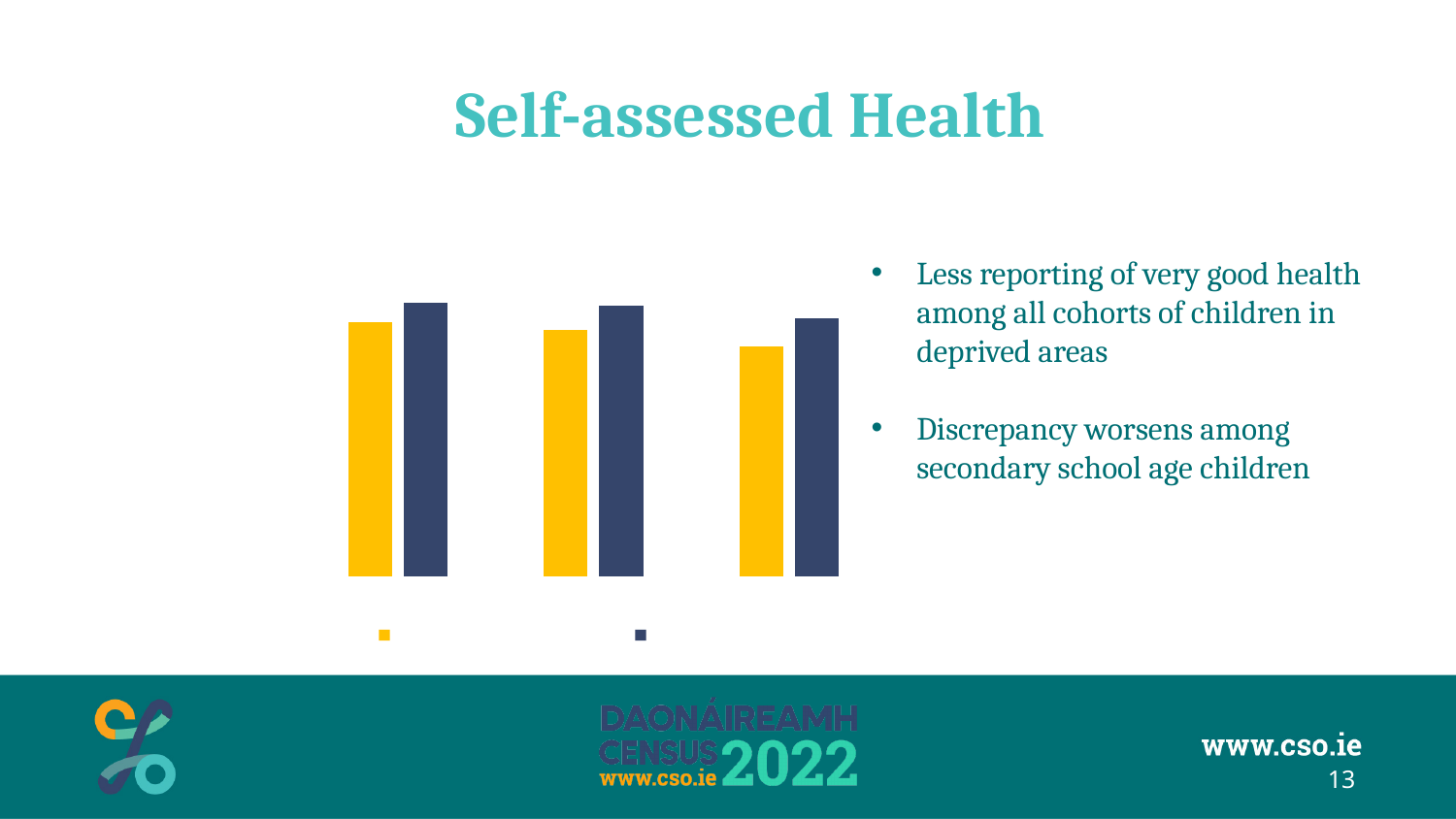
Which group of bars has the shortest yellow bar: the leftmost, middle or rightmost? rightmost Do the yellow bars rise or fall from left to right across the chart? fall What two colours are used for the bars in the chart? yellow and dark blue Which group of bars has the shortest dark blue bar: the leftmost, middle or rightmost? rightmost How many bars are plotted in total on the chart? 6 What kind of chart is shown on the slide? bar chart In the rightmost group of bars, which bar is taller, the yellow one or the dark blue one? the dark blue one Which group of bars has the tallest yellow bar: the leftmost, middle or rightmost? leftmost Is the gap between the yellow and dark blue bars larger in the leftmost group or the rightmost group? the rightmost group How many series does the chart's legend list? 2 In the leftmost group of bars, which bar is taller, the yellow one or the dark blue one? the dark blue one How many groups of bars does the chart show? 3